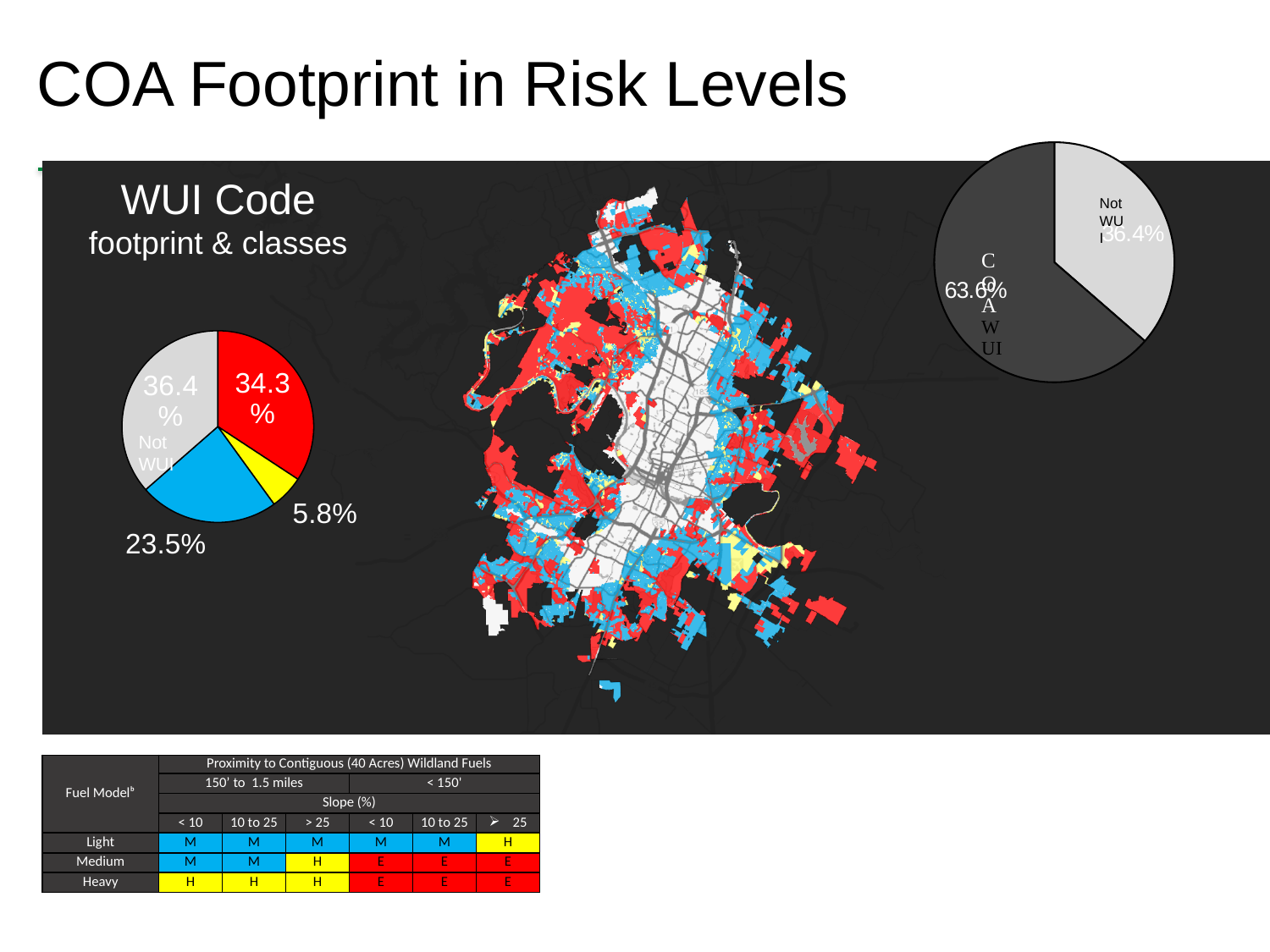
In the left pie chart titled 'WUI Code footprint & classes', what share does the yellow slice represent? 5.8% In the top-right pie chart, what share is labelled Not WUI? 36.4% What type of chart is the left chart titled 'WUI Code footprint & classes'? Pie chart How many slices does the top-right pie chart have? 2 In the left pie chart titled 'WUI Code footprint & classes', which slice is the smallest? 5.8% (yellow) In the top-right pie chart, which slice is larger, COA WUI or Not WUI? COA WUI In the top-right pie chart, what is the difference between the COA WUI share and the Not WUI share? 27.2% In the left pie chart titled 'WUI Code footprint & classes', what share is labelled Not WUI? 36.4% How many slices does the left pie chart titled 'WUI Code footprint & classes' have? 4 In the left pie chart titled 'WUI Code footprint & classes', what share does the blue slice represent? 23.5% In the top-right pie chart, what share is labelled COA WUI? 63.6% In the left pie chart titled 'WUI Code footprint & classes', what share does the red slice represent? 34.3%